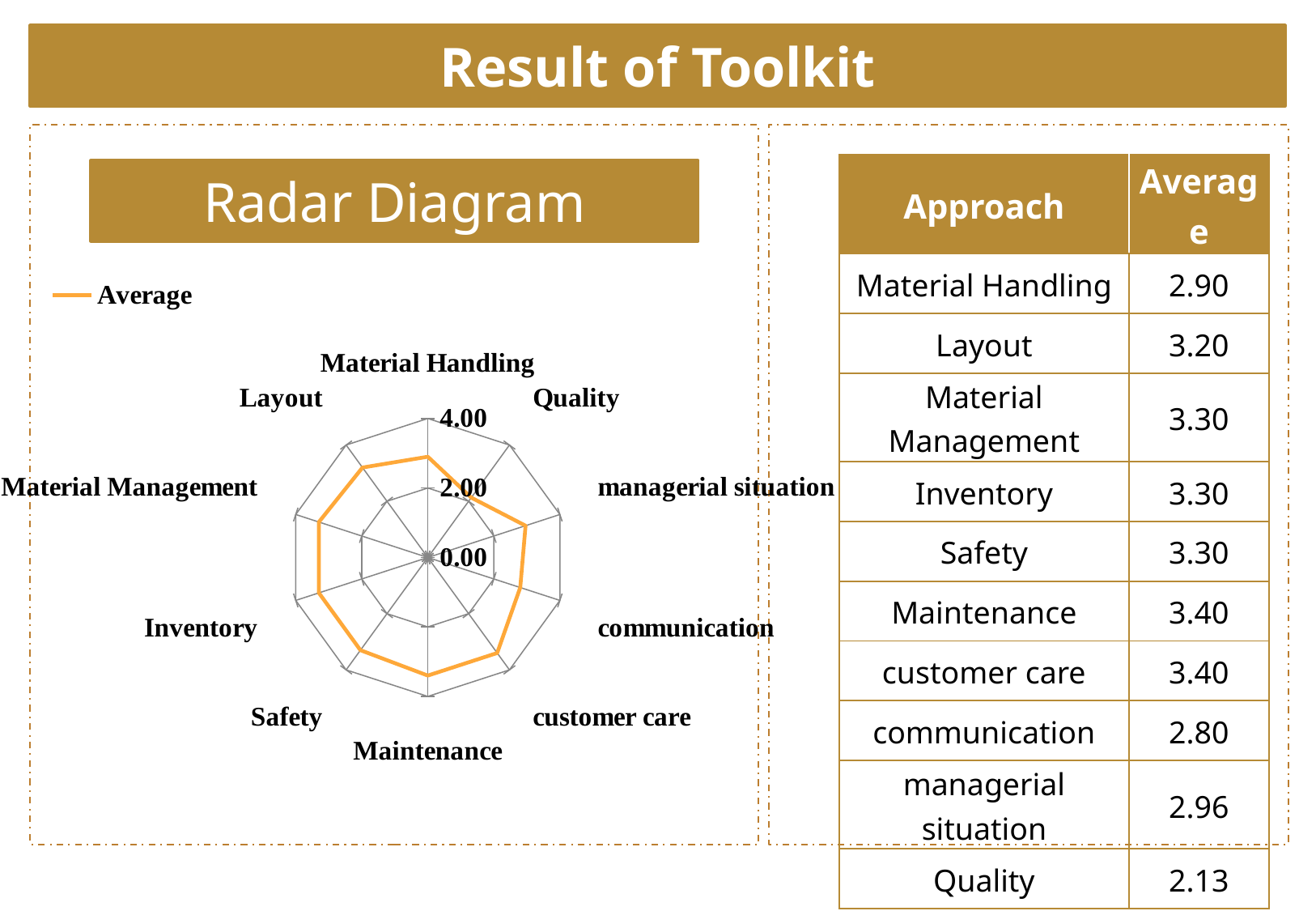
How many categories does the radar chart have? 10 What is the title shown above the radar chart? Radar Diagram What kind of chart is shown on the slide? radar chart What is the average value for communication? 2.80 What is the average value for Maintenance? 3.40 What is the name of the series shown in the radar chart legend? Average Which has a higher average value, Layout or Quality? Layout What is the difference between the average values for Layout and Material Handling? 0.30 What is the average value for Quality? 2.13 Is the value for Maintenance on the radar chart greater or less than 2.00? greater Which category has the lowest average value? Quality How many series does the legend of the radar chart list? 1